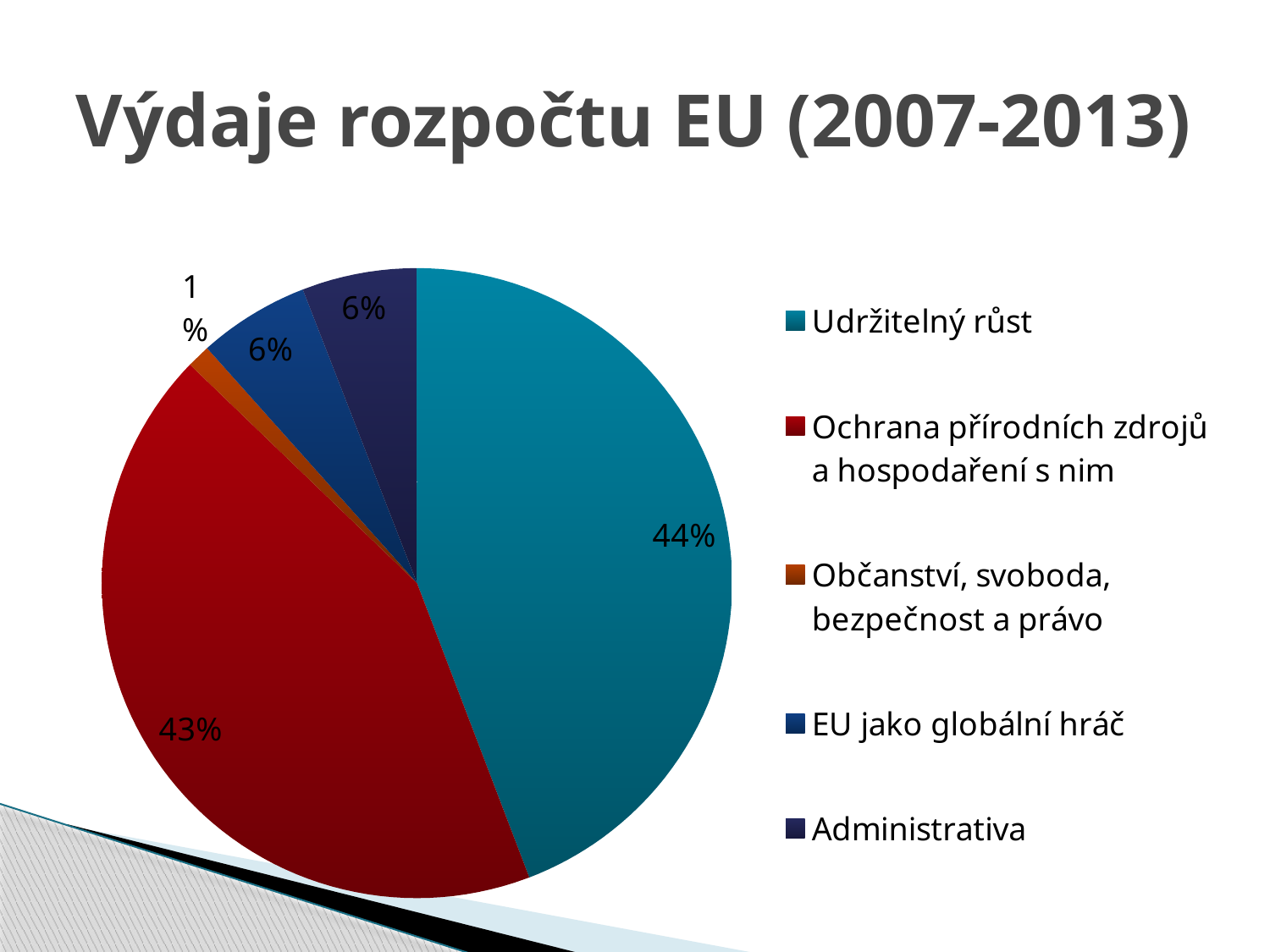
Which is larger, the share of EU jako globální hráč or the share of Občanství, svoboda, bezpečnost a právo? EU jako globální hráč What is the difference between the shares of Udržitelný růst and Ochrana přírodních zdrojů a hospodaření s nim? 1% What is the title of the chart on the slide? Výdaje rozpočtu EU (2007-2013) What kind of chart is shown on the slide? pie chart Which category has the largest slice of the pie? Udržitelný růst What share of the pie does Udržitelný růst have? 44% What share of the pie does Administrativa have? 6% Which category has the smallest slice of the pie? Občanství, svoboda, bezpečnost a právo What share of the pie does Občanství, svoboda, bezpečnost a právo have? 1% How many categories does the pie chart have? 5